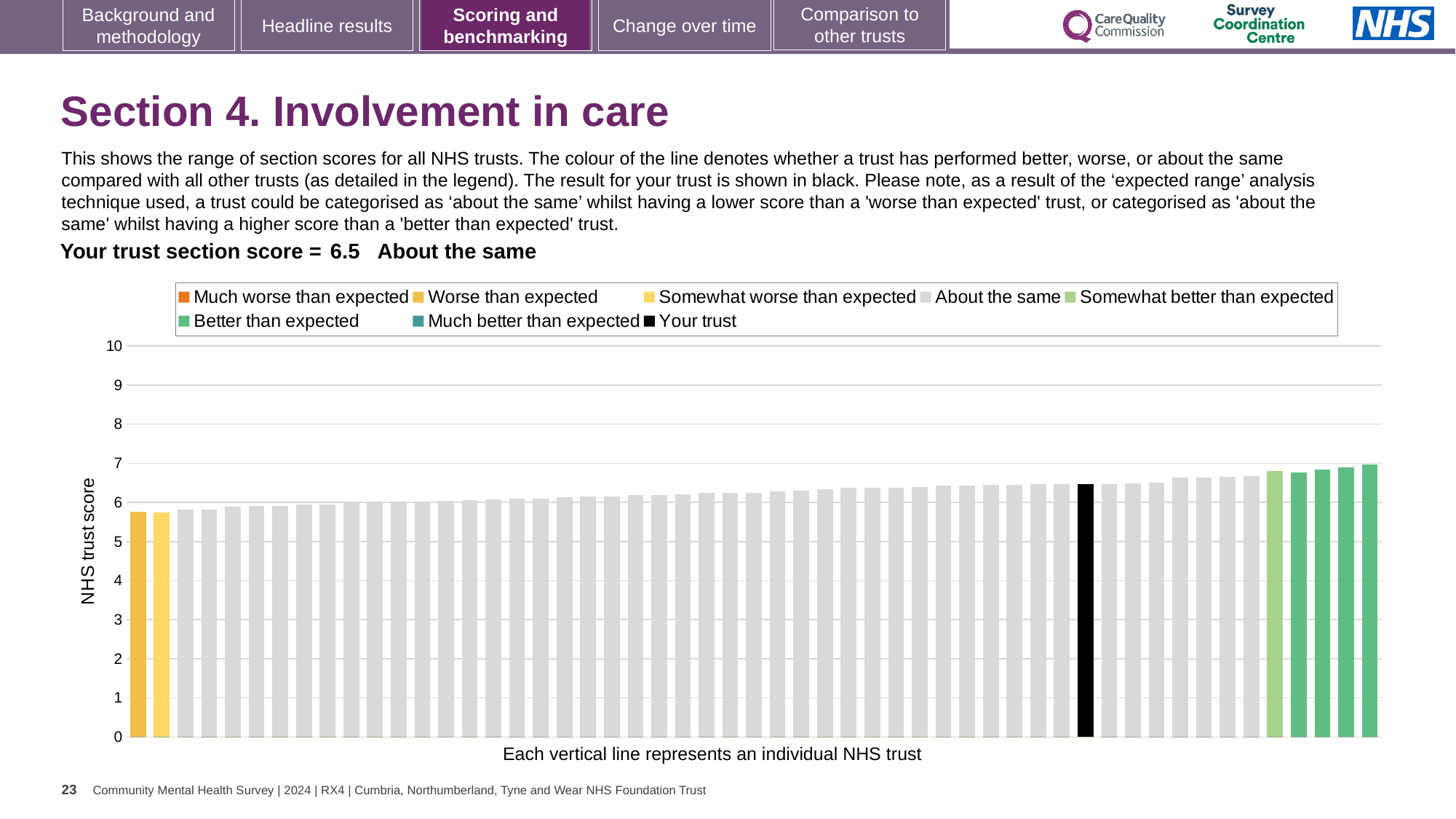
How many entries does the chart legend list? 8 Do the bar values rise or fall from left to right along the x axis? Rise What is the label on the vertical axis of the chart? NHS trust score What is the maximum value shown on the vertical axis? 10 Is the value for your trust (the black bar) greater or less than 6? greater Is the value of the lowest bar on the chart greater or less than 5? greater What kind of chart is shown on the slide? Bar chart How is your trust's score categorised compared with other trusts? About the same Is the value of the highest bar on the chart greater or less than 8? less What is the section score for your trust shown on the slide? 6.5 What colour is used for the bar representing your trust? Black